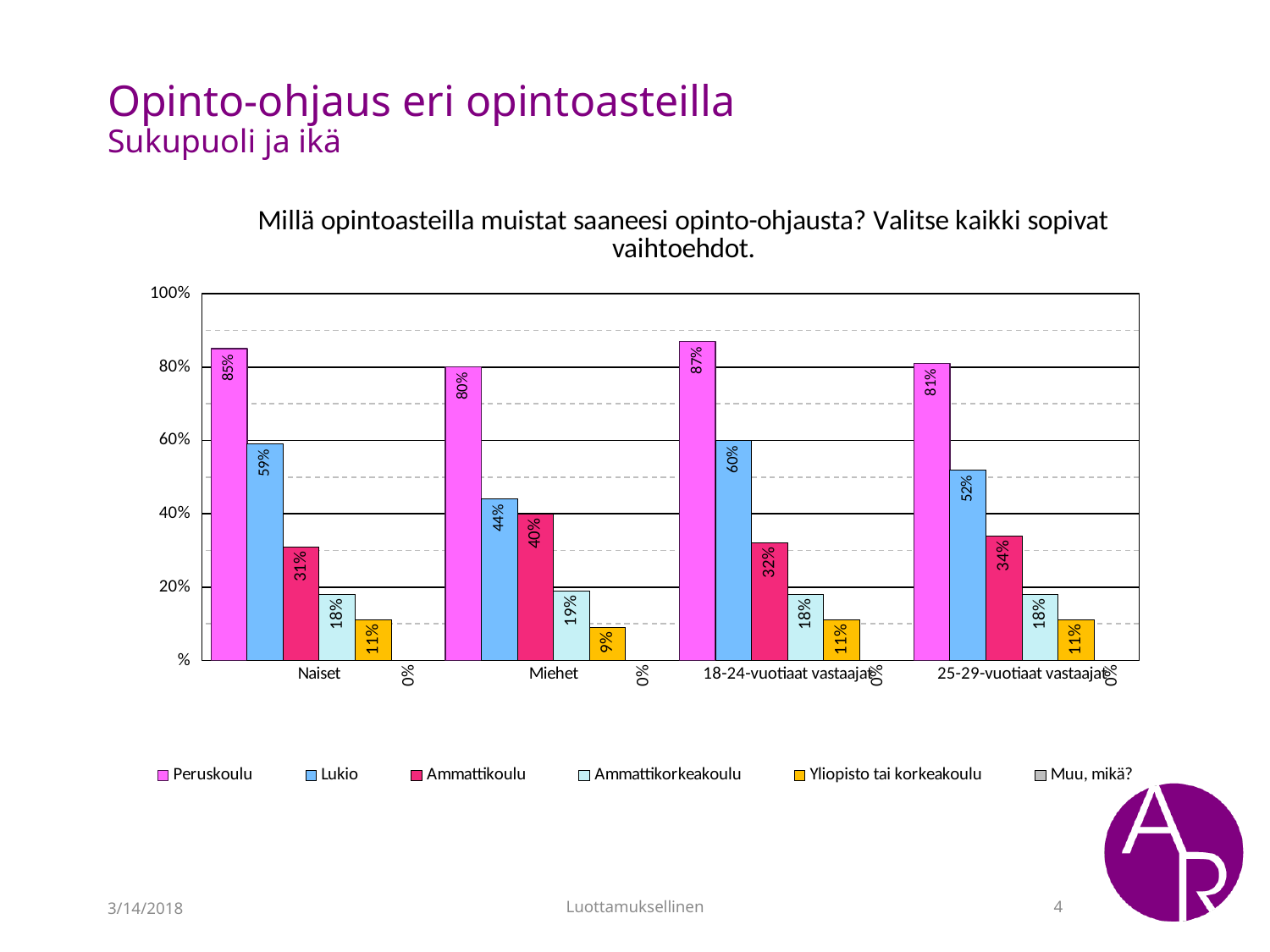
What is the difference between the Peruskoulu values for Naiset and Miehet? 5% What is the value for Yliopisto tai korkeakoulu in the Miehet group? 9% What kind of chart is shown on the slide? bar chart What is the value for Lukio in the Miehet group? 44% How many groups are shown on the x axis? 4 Which is larger: Ammattikoulu for Miehet or Ammattikoulu for Naiset? Miehet How many series does the legend list? 6 What is the value for Ammattikoulu in the 25-29-vuotiaat vastaajat group? 34% What is the value for Peruskoulu in the Naiset group? 85% Which group has the highest value for Peruskoulu? 18-24-vuotiaat vastaajat Which group has the lowest value for Lukio? Miehet What is the value for Muu, mikä? in the Naiset group? 0%